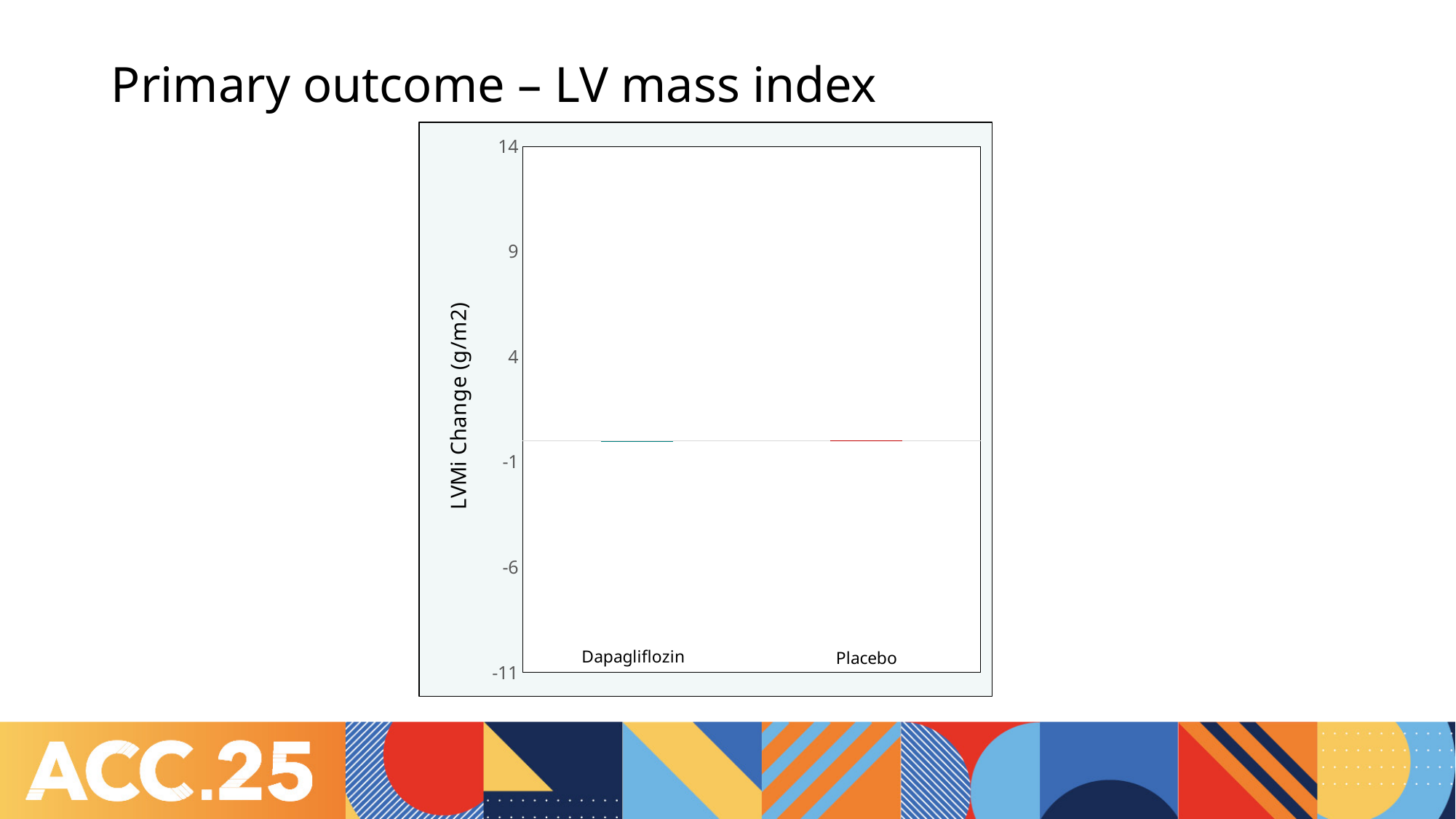
What kind of chart is shown on the slide? bar chart Is the value for Dapagliflozin greater or less than 4? less What is the lowest tick value shown on the y axis of the chart? -11 How many categories are shown on the x axis of the chart? 2 Is the value for Placebo greater or less than -6? greater What is the label of the y axis of the chart? LVMi Change (g/m2) What are the two categories shown on the x axis of the chart? Dapagliflozin and Placebo Is the value for Dapagliflozin greater or less than -6? greater What is the highest tick value shown on the y axis of the chart? 14